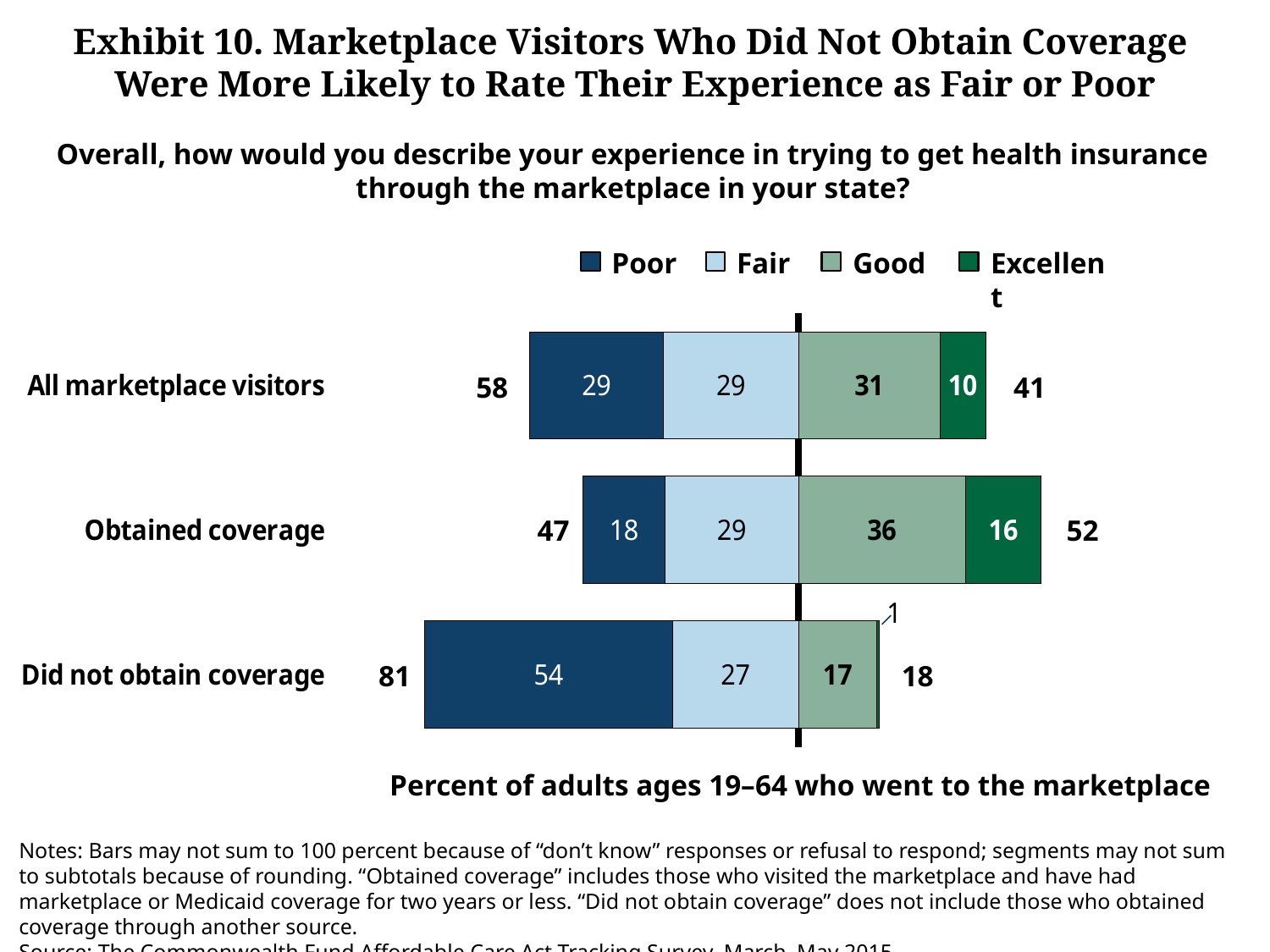
Which group has the highest Poor value? Did not obtain coverage What percent of adults who did not obtain coverage rated their experience as Poor? 54 What kind of chart is shown? Stacked bar chart How many series does the legend list? 4 What is the Good value for All marketplace visitors? 31 What is the difference between the Poor values for Did not obtain coverage and Obtained coverage? 36 How many groups are plotted in the chart? 3 What is the combined Fair or Poor subtotal shown for Did not obtain coverage? 81 Which group has the lowest Excellent value? Did not obtain coverage Which is larger, the Good value for Obtained coverage or the Good value for All marketplace visitors? Obtained coverage What is the combined Good or Excellent subtotal shown for Obtained coverage? 52 What percent of adults who obtained coverage rated their experience as Excellent? 16